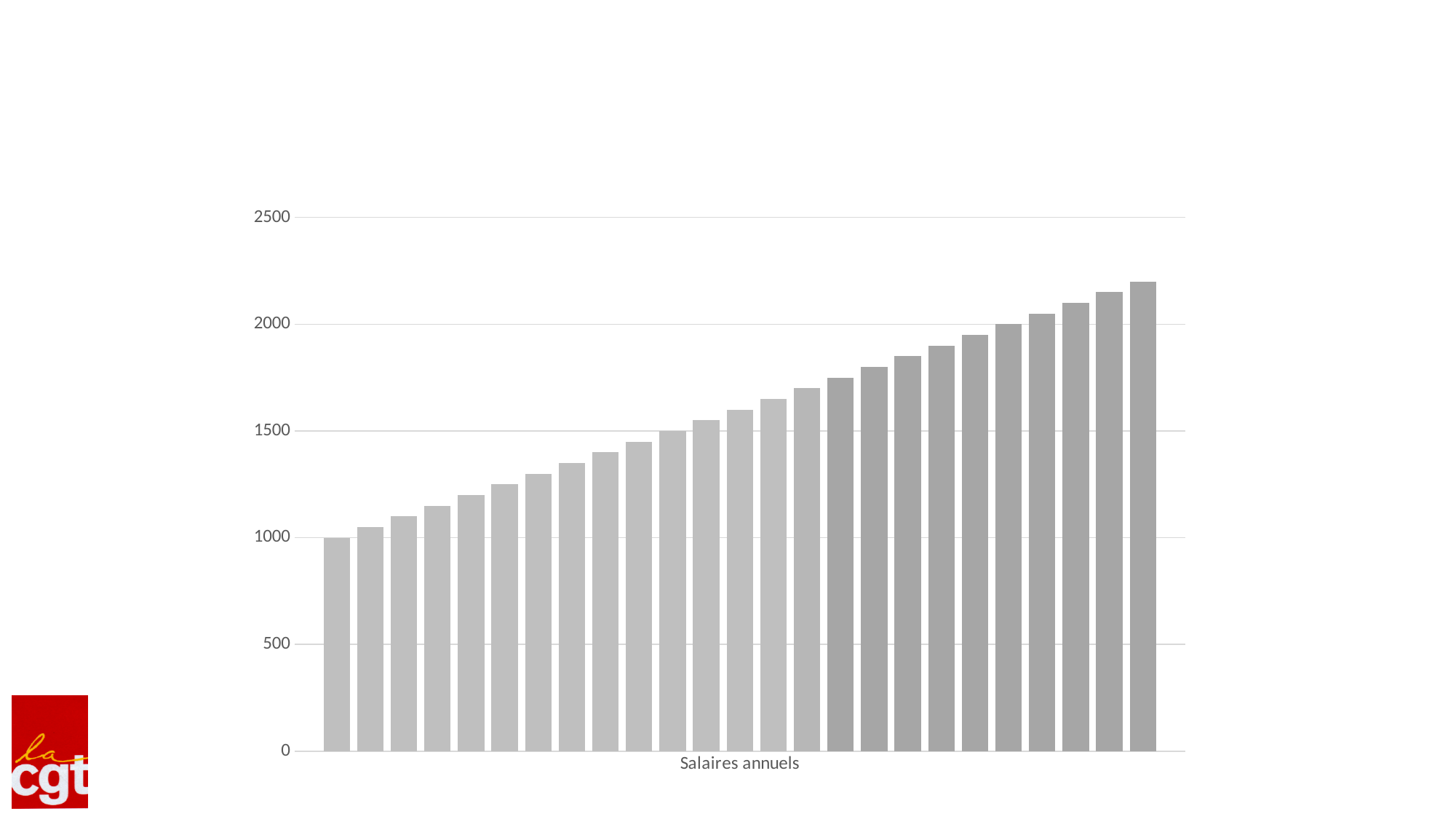
Which bar has the highest value in the chart? the rightmost bar Is the value of the leftmost bar greater or less than 1500? less Is the value of the rightmost bar greater or less than 2000? greater Which bar has the lowest value in the chart? the leftmost bar What is the highest value shown on the vertical axis of the chart? 2500 What is the label shown on the horizontal axis of the chart? Salaires annuels What is the value of the leftmost bar? 1000 What kind of chart is shown on the slide? bar chart Do the bar values rise or fall from left to right across the chart? rise Which is larger, the value of the leftmost bar or the value of the rightmost bar? the rightmost bar How many bars are plotted in the chart? 25